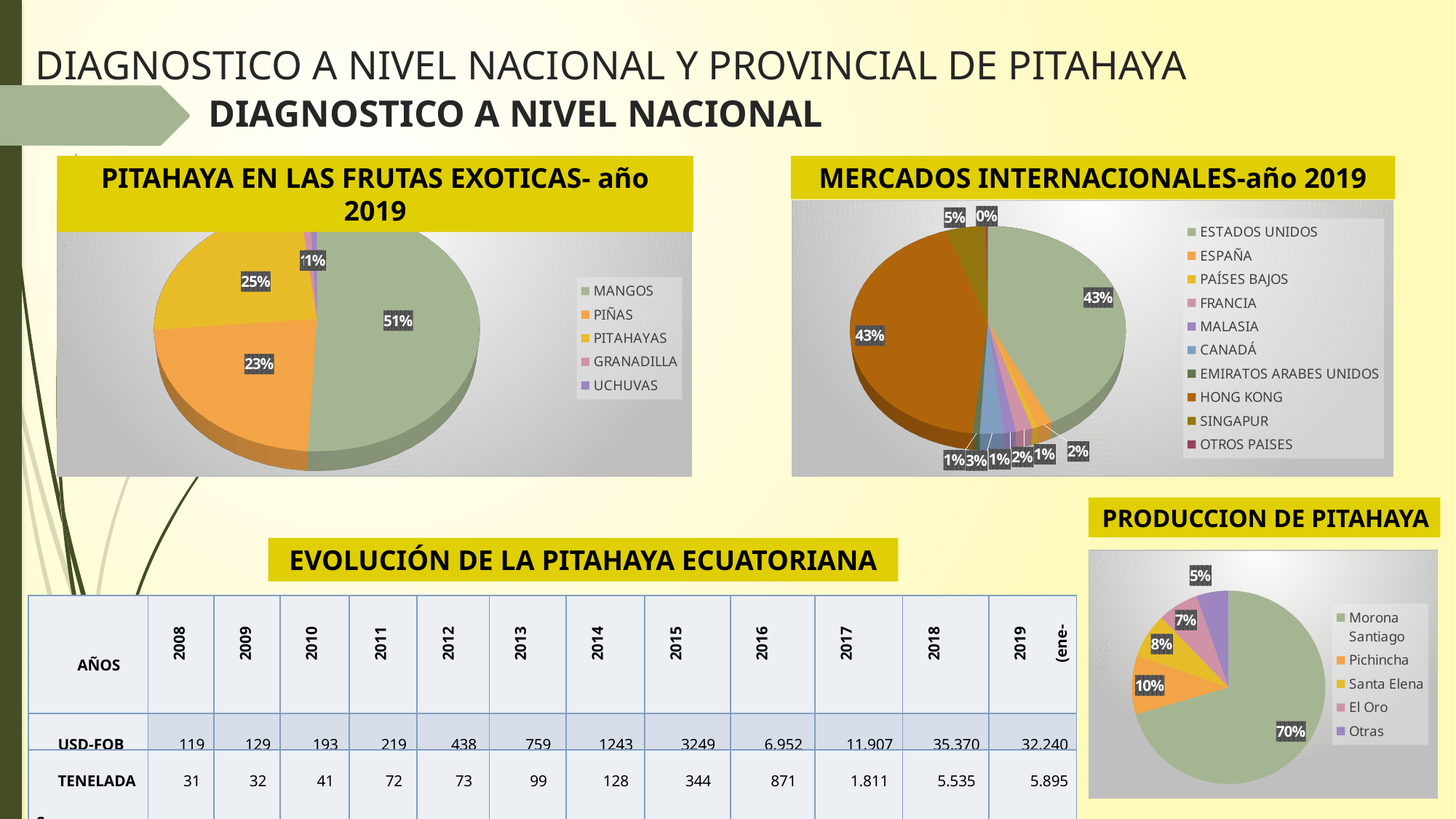
In the MERCADOS INTERNACIONALES-año 2019 chart, what share does SINGAPUR have? 5% In the PITAHAYA EN LAS FRUTAS EXOTICAS- año 2019 chart, which has the larger share, PITAHAYAS or PIÑAS? PITAHAYAS In the PRODUCCION DE PITAHAYA chart, how many percentage points larger is Morona Santiago's share than Pichincha's? 60 percentage points In the PITAHAYA EN LAS FRUTAS EXOTICAS- año 2019 chart, what share do PITAHAYAS have? 25% In the PRODUCCION DE PITAHAYA chart, which category has the smallest share? Otras In the PITAHAYA EN LAS FRUTAS EXOTICAS- año 2019 chart, what share do MANGOS have? 51% What kind of chart is the PRODUCCION DE PITAHAYA chart? Pie chart How many categories does the legend of the PRODUCCION DE PITAHAYA chart list? 5 In the PRODUCCION DE PITAHAYA chart, what share does Pichincha have? 10% In the PRODUCCION DE PITAHAYA chart, what share does Morona Santiago have? 70% How many entries does the legend of the MERCADOS INTERNACIONALES-año 2019 chart list? 10 In the PRODUCCION DE PITAHAYA chart, which province has the largest share? Morona Santiago